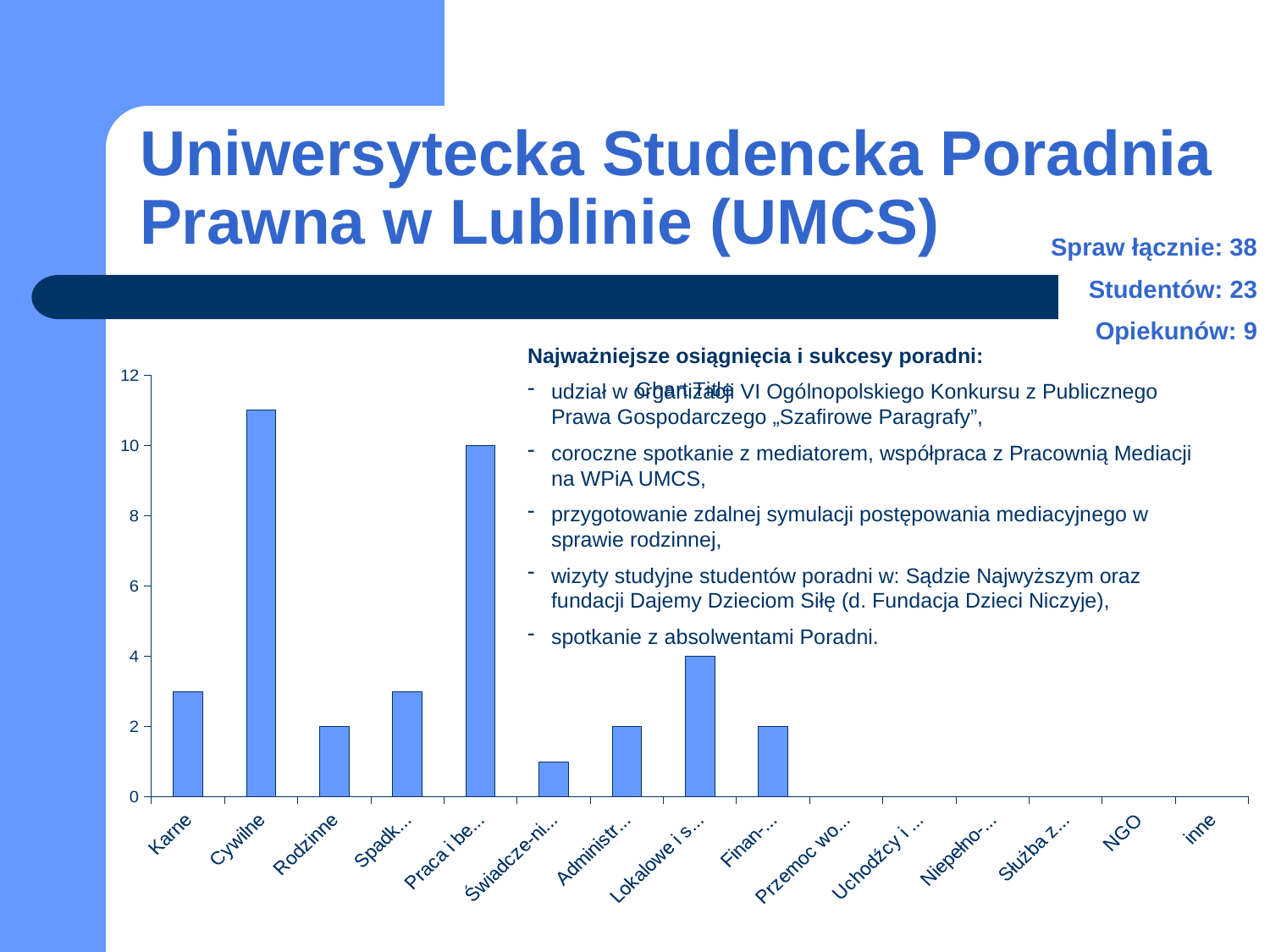
What kind of chart is shown on the slide? bar chart Which category has the highest value in the chart? Cywilne What is the value for Praca i be... in the chart? 10 Is the value for Karne greater or less than 4? less What is the difference between the value for Praca i be... and the value for Lokalowe i s...? 6 Is the value for Świadcze-ni... greater or less than 2? less What is the value for Rodzinne in the chart? 2 How many categories are shown on the x axis of the chart? 15 Is the value for Cywilne greater or less than 10? greater Which is larger, the value for Karne or the value for Rodzinne? Karne What is the value for NGO in the chart? 0 What is the value for Lokalowe i s... in the chart? 4